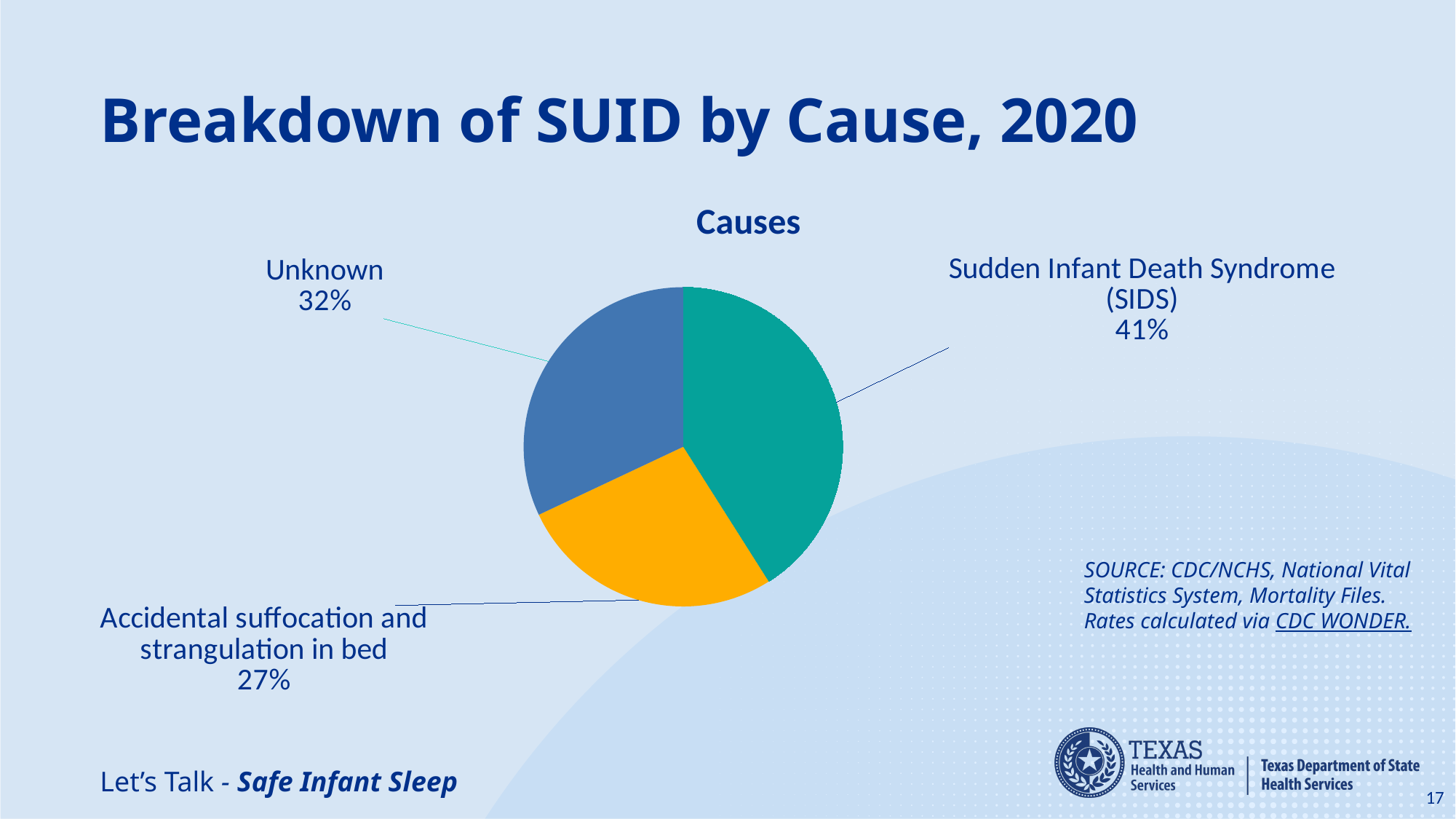
What is the difference in percentage points between the SIDS share and the Unknown share? 9 Which cause has the largest share of the pie? Sudden Infant Death Syndrome (SIDS) Which is larger, the share for Unknown or the share for Accidental suffocation and strangulation in bed? Unknown What is the title of the chart? Causes How many slices does the pie chart have? 3 What colour is the slice for Accidental suffocation and strangulation in bed? orange What is the difference in percentage points between the Unknown share and the Accidental suffocation and strangulation in bed share? 5 What share of SUID is attributed to Sudden Infant Death Syndrome (SIDS)? 41% What kind of chart is shown on the slide? pie chart What share of SUID is attributed to Unknown causes? 32% What share of SUID is attributed to Accidental suffocation and strangulation in bed? 27% Which cause has the smallest share of the pie? Accidental suffocation and strangulation in bed